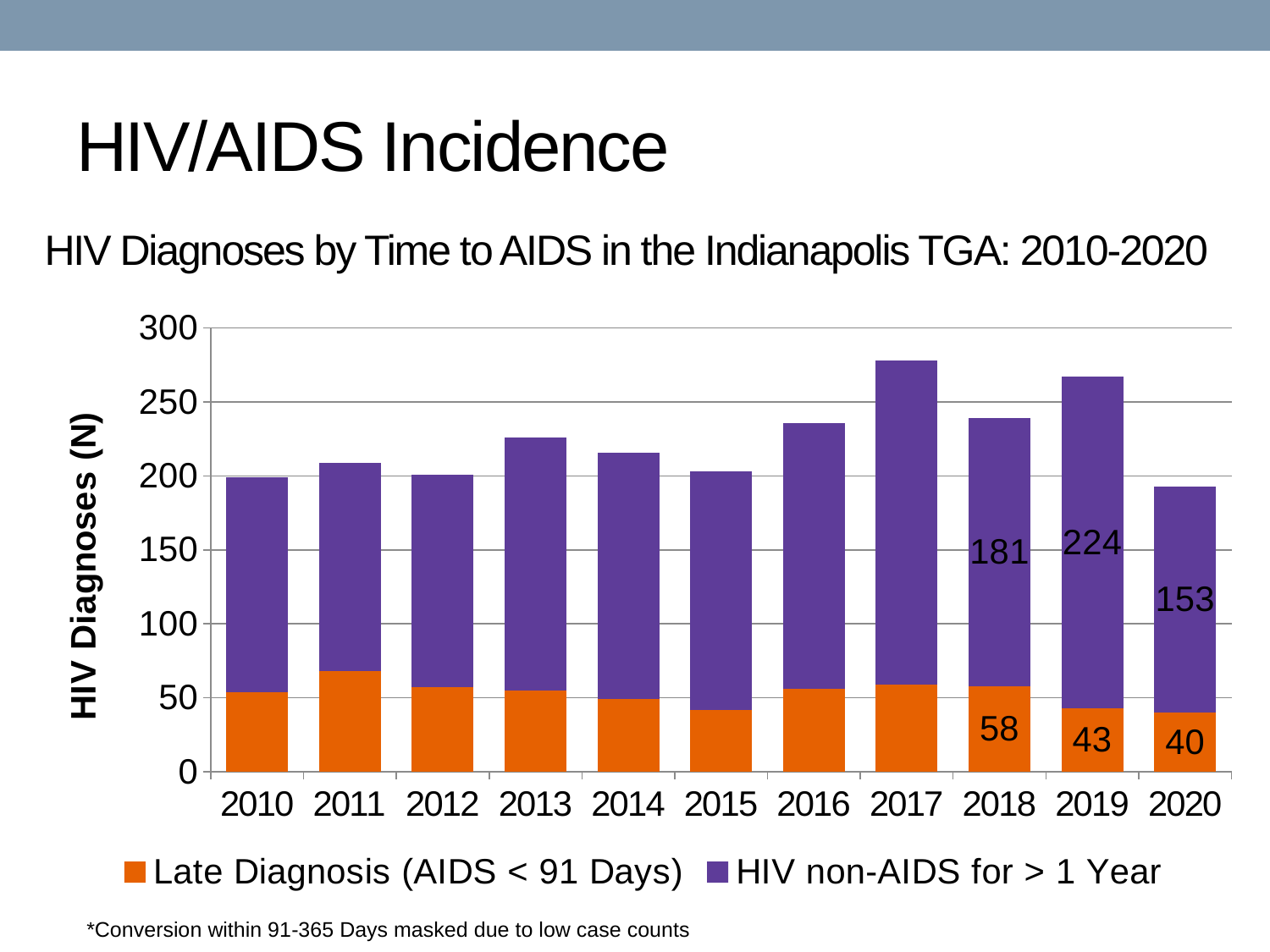
What is the value for HIV non-AIDS for > 1 Year in 2019? 224 How many series does the legend list? 2 What is the difference between the HIV non-AIDS for > 1 Year values in 2019 and 2018? 43 What is the total number of HIV diagnoses in 2019 (sum of both series)? 267 How many years are shown on the x axis? 11 Which year has the highest Late Diagnosis (AIDS < 91 Days) value? 2011 What is the total number of HIV diagnoses in 2020 (sum of both series)? 193 Is the total bar height for 2017 greater or less than 250? greater What is the value for Late Diagnosis (AIDS < 91 Days) in 2018? 58 What is the value for HIV non-AIDS for > 1 Year in 2020? 153 Which is larger: the HIV non-AIDS for > 1 Year value in 2019 or in 2020? 2019 What is the value for Late Diagnosis (AIDS < 91 Days) in 2019? 43